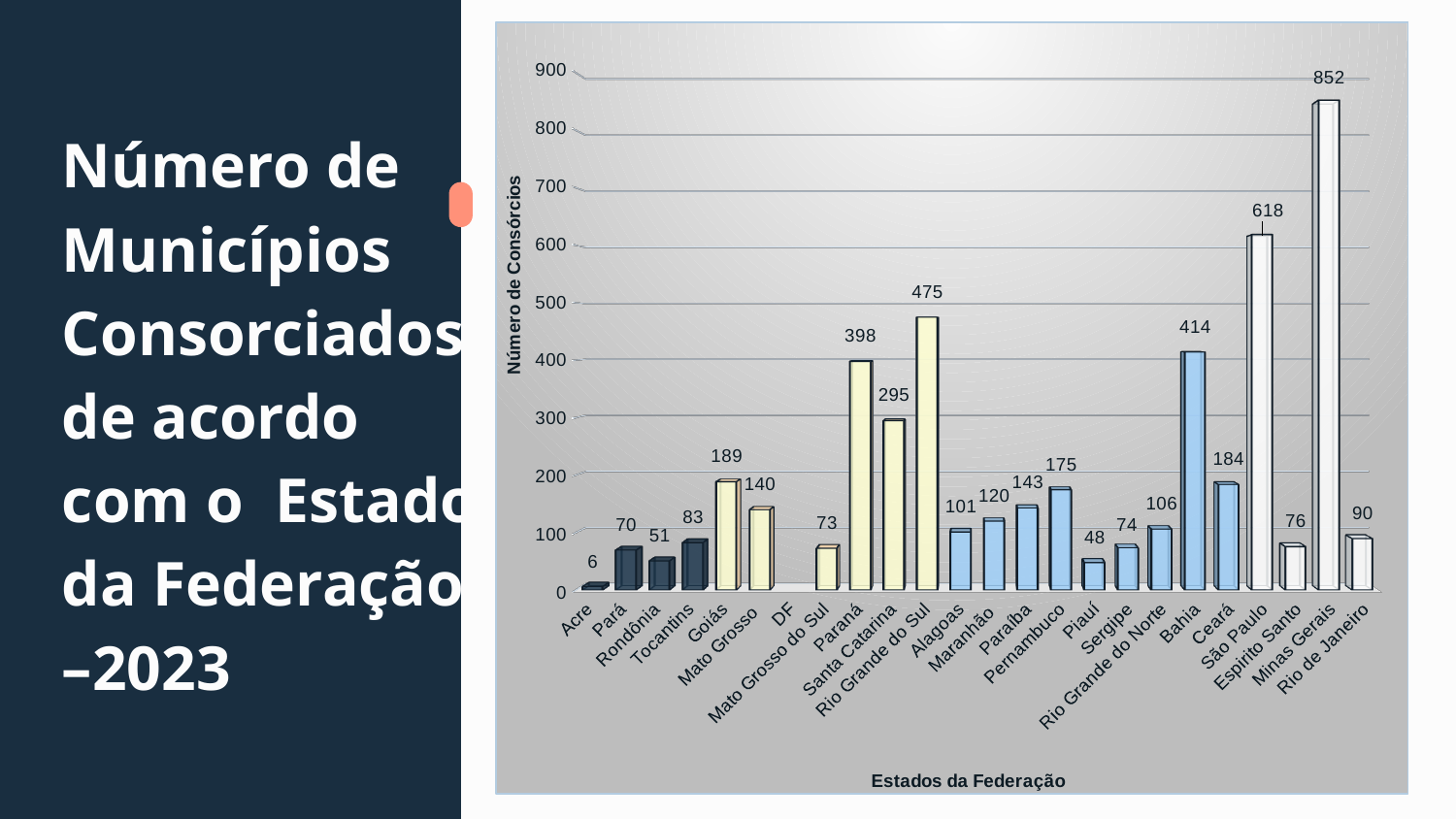
What is the value for Pernambuco? 175 Which is larger, the value for Paraná or the value for Bahia? Bahia What is the difference between the values for Bahia and Ceará? 230 What is the value for Rio Grande do Sul? 475 What is the difference between the values for Minas Gerais and São Paulo? 234 Is the value for Santa Catarina greater or less than 200? greater What is the value for Minas Gerais? 852 Which state has the highest value? Minas Gerais What kind of chart is shown on the slide? bar chart What is the title of the vertical axis? Número de Consórcios What is the value for Acre? 6 What is the title of the horizontal axis? Estados da Federação